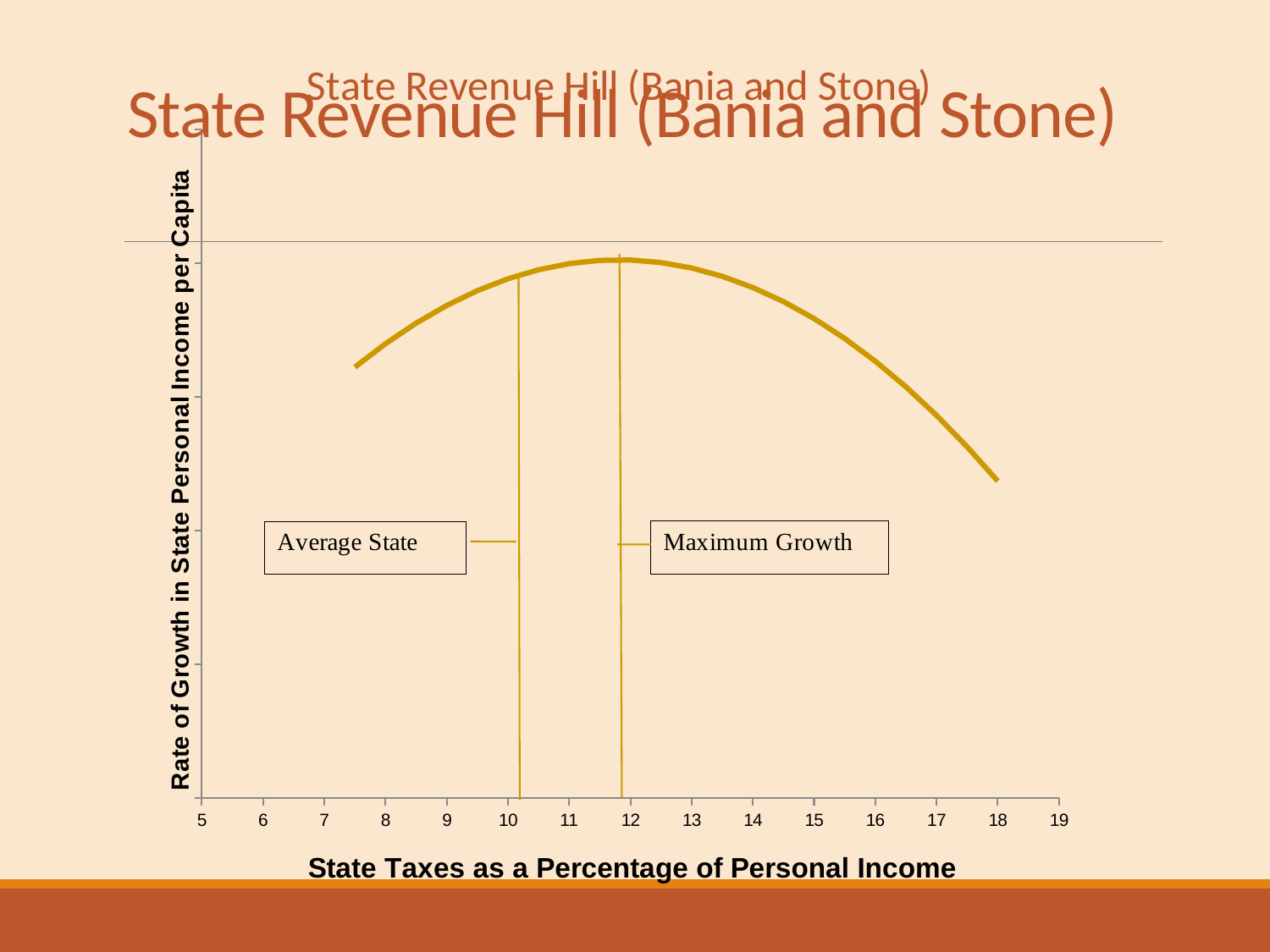
What is the highest value labelled on the x axis? 19 Is the x-axis position of the Average State line greater or less than 11? less Is the x-axis position of the Average State line greater or less than 9? greater How many tick labels are shown on the x axis? 15 What is the lowest value labelled on the x axis? 5 Is the x-axis position of the Maximum Growth line greater or less than 11? greater Does the curve rise or fall as the x axis moves from 12 to 18? fall Does the curve rise or fall as the x axis moves from 8 to 11? rise Which vertical marker is at a higher state tax percentage, Average State or Maximum Growth? Maximum Growth What is the label of the x axis? State Taxes as a Percentage of Personal Income What kind of chart is shown on the slide? line chart What is the title of the chart? State Revenue Hill (Bania and Stone)